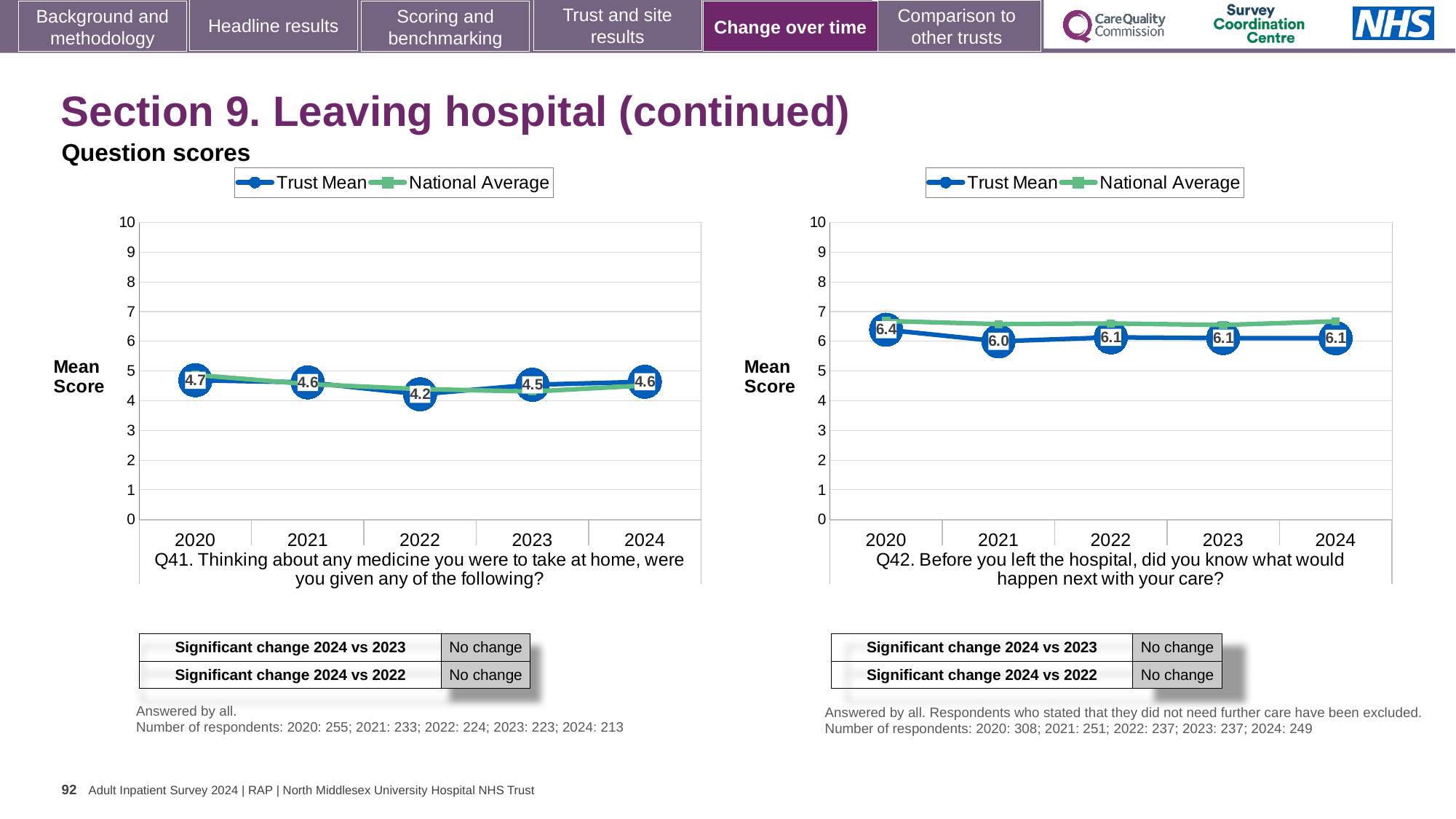
On the Q41 chart, what is the Trust Mean score for 2020? 4.7 On the Q42 chart, is the National Average value for 2024 greater or less than 6? greater On the Q41 chart, what is the difference between the Trust Mean scores for 2020 and 2022? 0.5 On the Q42 chart, what is the Trust Mean score for 2021? 6.0 How many series does the legend of the Q42 chart list? 2 On the Q42 chart, what is the Trust Mean score for 2020? 6.4 What type of chart is used for Q41? Line chart On the Q41 chart, what is the Trust Mean score for 2022? 4.2 On the Q42 chart, which year has the highest Trust Mean score? 2020 On the Q41 chart, which year has the lowest Trust Mean score? 2022 On the Q42 chart, is the Trust Mean score for 2020 larger or smaller than the score for 2021? larger How many years are plotted on the Q41 chart? 5